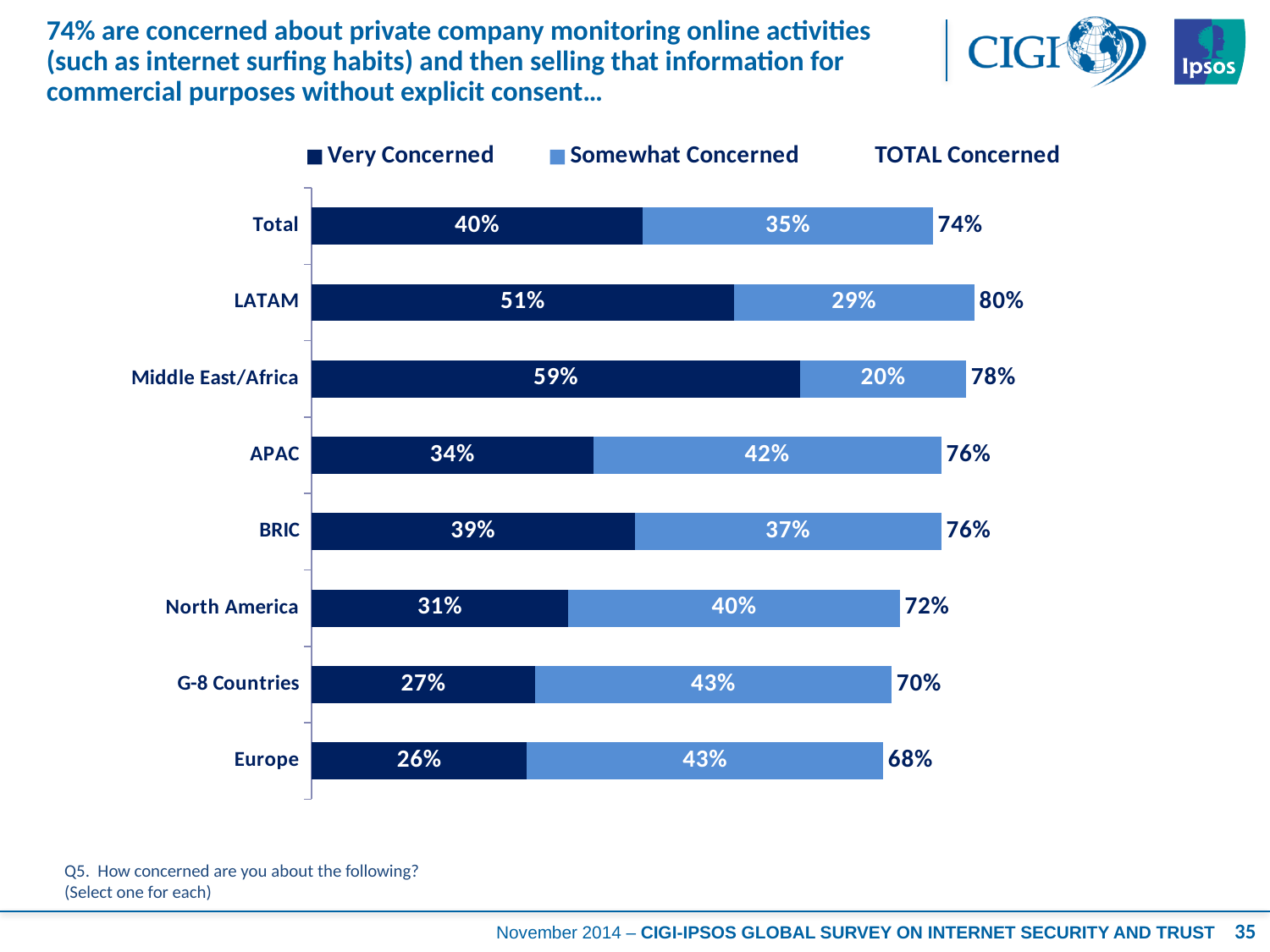
Which is larger, the Somewhat Concerned value for G-8 Countries or for BRIC? G-8 Countries What is the difference between the Very Concerned values for Middle East/Africa and Europe? 33% What is the TOTAL Concerned value for LATAM? 80% What is the Somewhat Concerned value for APAC? 42% What percentage of respondents in LATAM are Very Concerned? 51% How many categories (regions, including Total) are shown on the chart? 8 What kind of chart is shown on the slide? Stacked bar chart How many series does the legend list with coloured markers? 2 Which region has the highest Very Concerned percentage? Middle East/Africa What is the TOTAL Concerned value for North America? 72% Which region has the lowest TOTAL Concerned percentage? Europe Which series is shown in the darker blue colour? Very Concerned